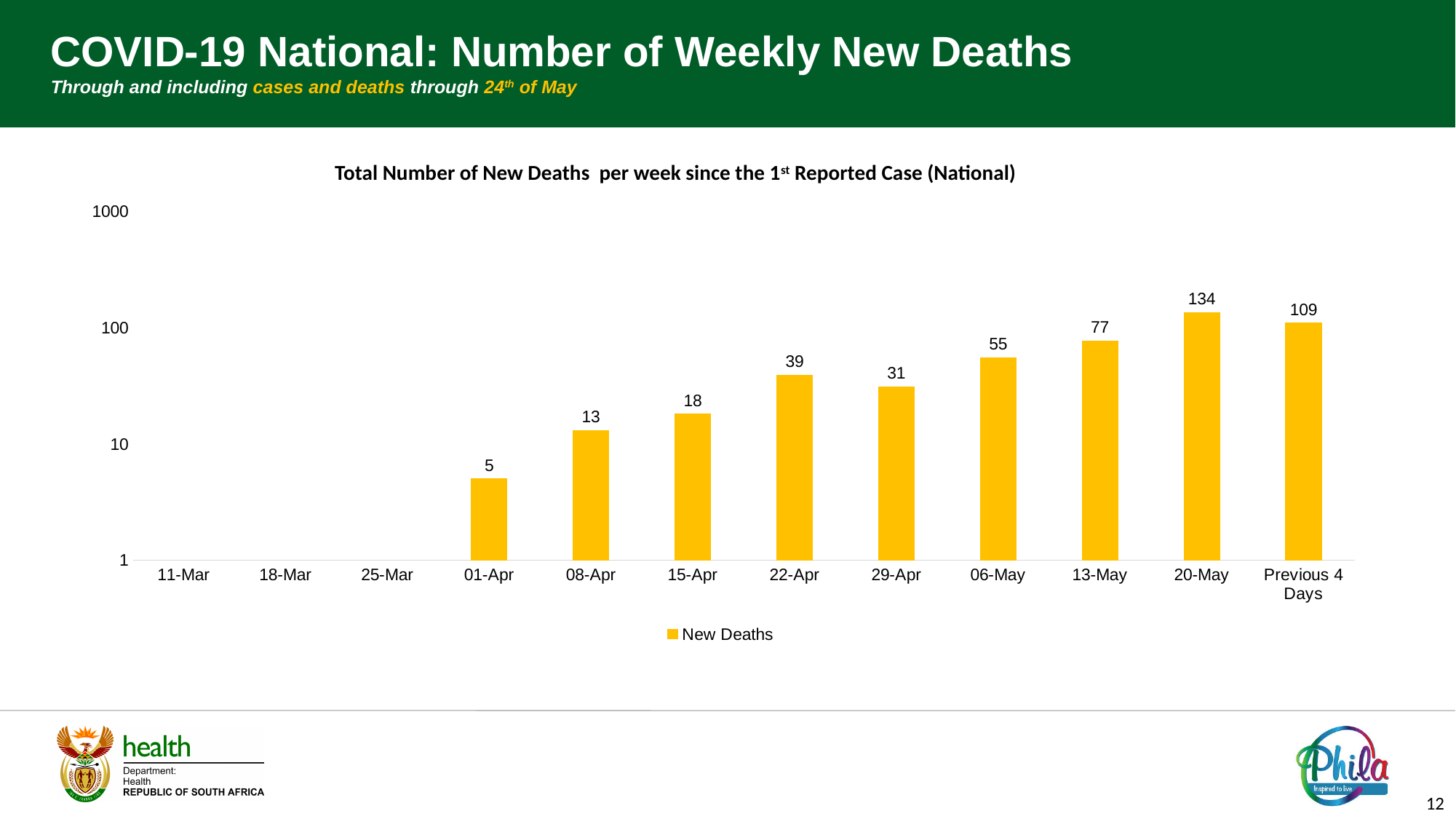
What is the value for 01-Apr? 5 What is the difference between the values for 20-May and 13-May? 57 Which is larger, the value for 22-Apr or the value for 29-Apr? 22-Apr Which category has the highest number of new deaths? 20-May Is the value for 06-May greater or less than 100? less What is the value for Previous 4 Days? 109 How many series does the legend list? 1 How many categories are shown on the x axis? 12 What is the legend entry for the series? New Deaths What is the value for 20-May? 134 Do the values generally rise or fall from 01-Apr to 20-May? rise What kind of chart is shown? bar chart